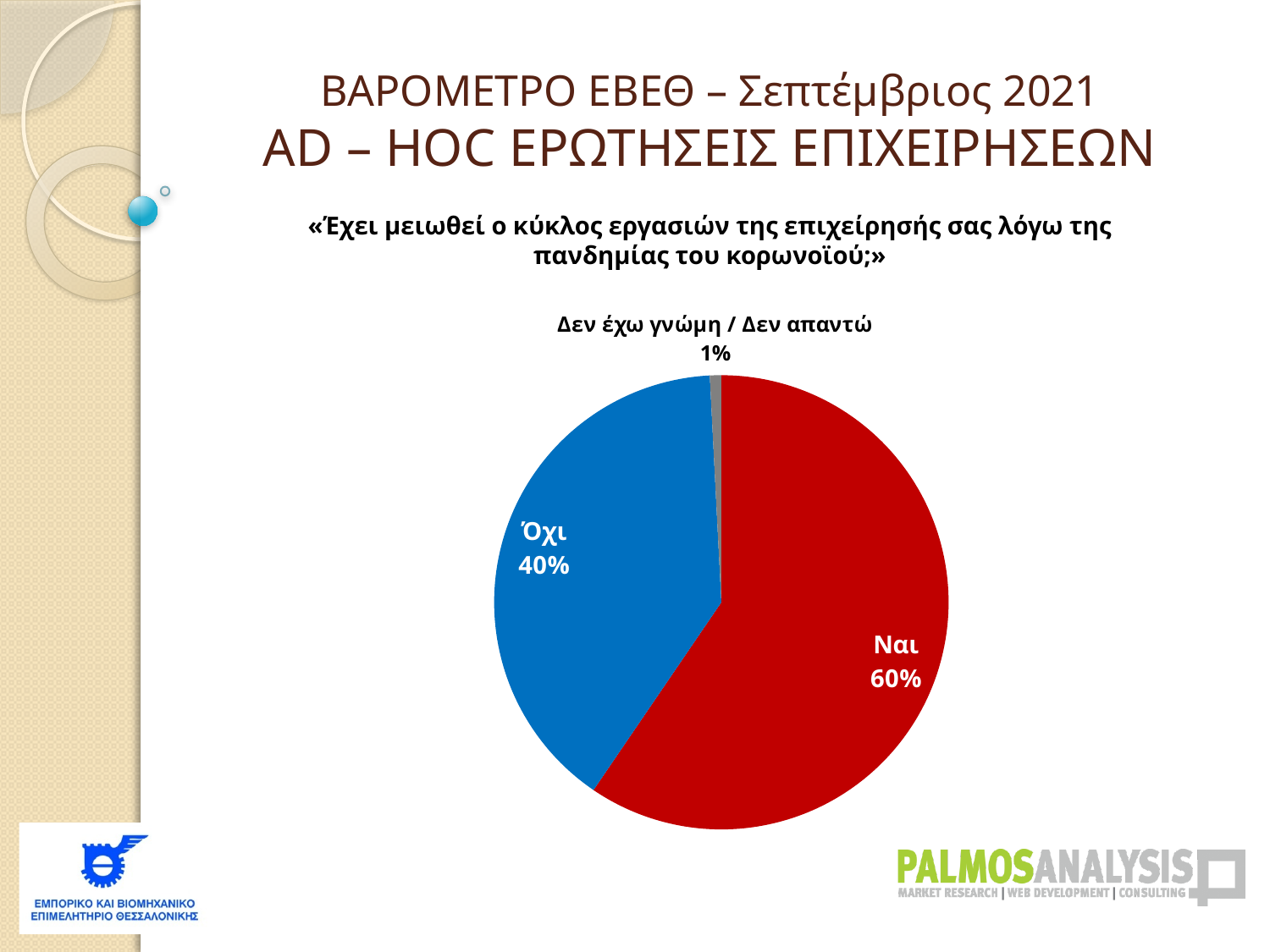
What kind of chart is shown on the slide? Pie chart What share of the pie does the "Ναι" slice represent? 60% What share of the pie does the "Δεν έχω γνώμη / Δεν απαντώ" slice represent? 1% What colour is the "Ναι" slice of the pie? Red What is the difference in percentage points between the "Ναι" and "Όχι" slices? 20 How many slices does the pie chart have? 3 What share of the pie does the "Όχι" slice represent? 40% Which slice of the pie is the smallest? Δεν έχω γνώμη / Δεν απαντώ Which is larger, the "Ναι" slice or the "Όχι" slice? Ναι Which slice of the pie is the largest? Ναι What colour is the "Όχι" slice of the pie? Blue